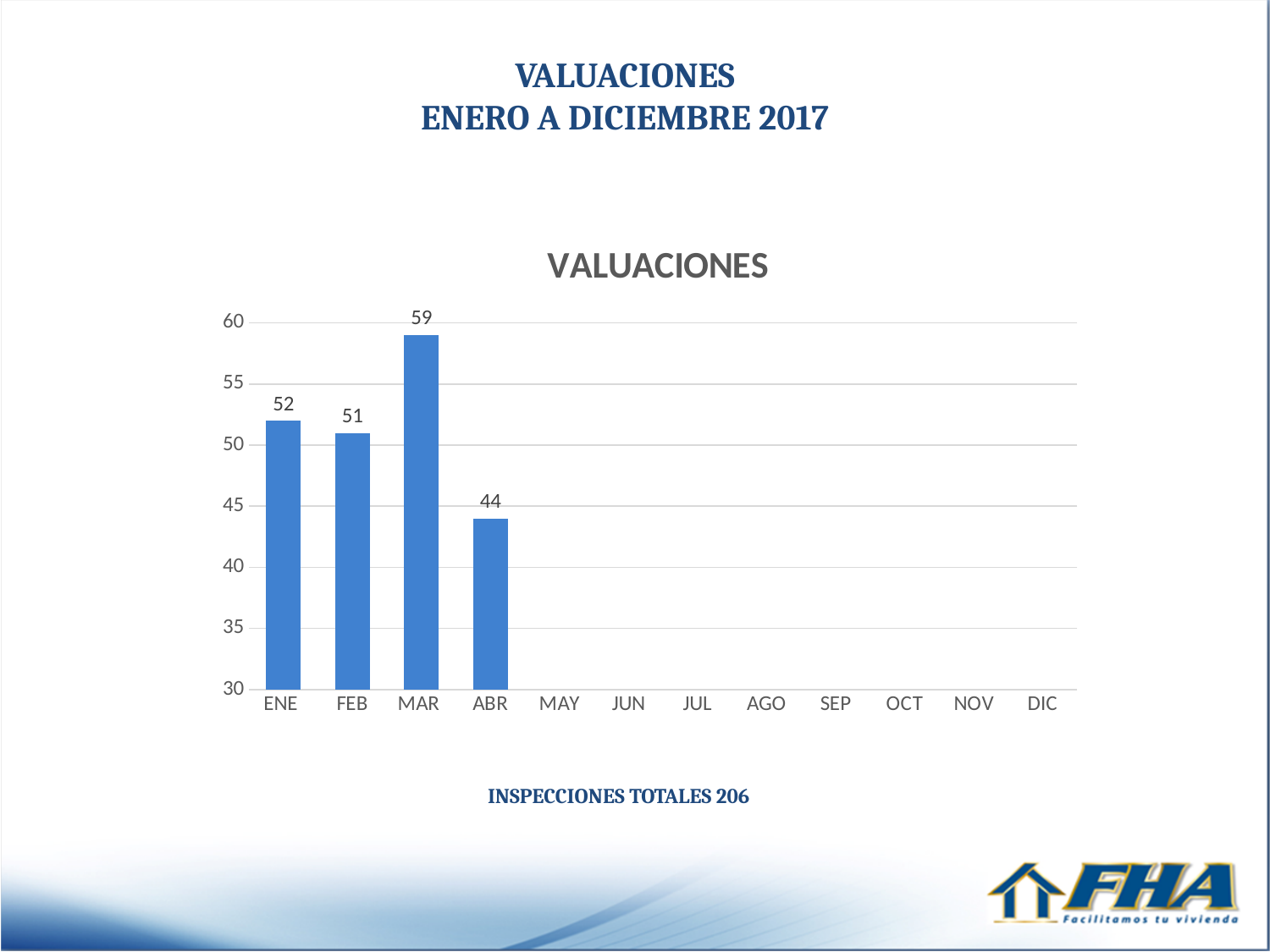
What is the value for ENE? 52 What is the value for MAR? 59 What is the value for FEB? 51 Is the value for ABR greater or less than 45? less What is the value for ABR? 44 Among the months with bars, which has the lowest value? ABR What kind of chart is shown? bar chart Which is larger, the value for ENE or the value for FEB? ENE What is the title of the chart? VALUACIONES How many months have a bar plotted on the chart? 4 What is the difference between the values for MAR and ABR? 15 Which month has the highest value? MAR